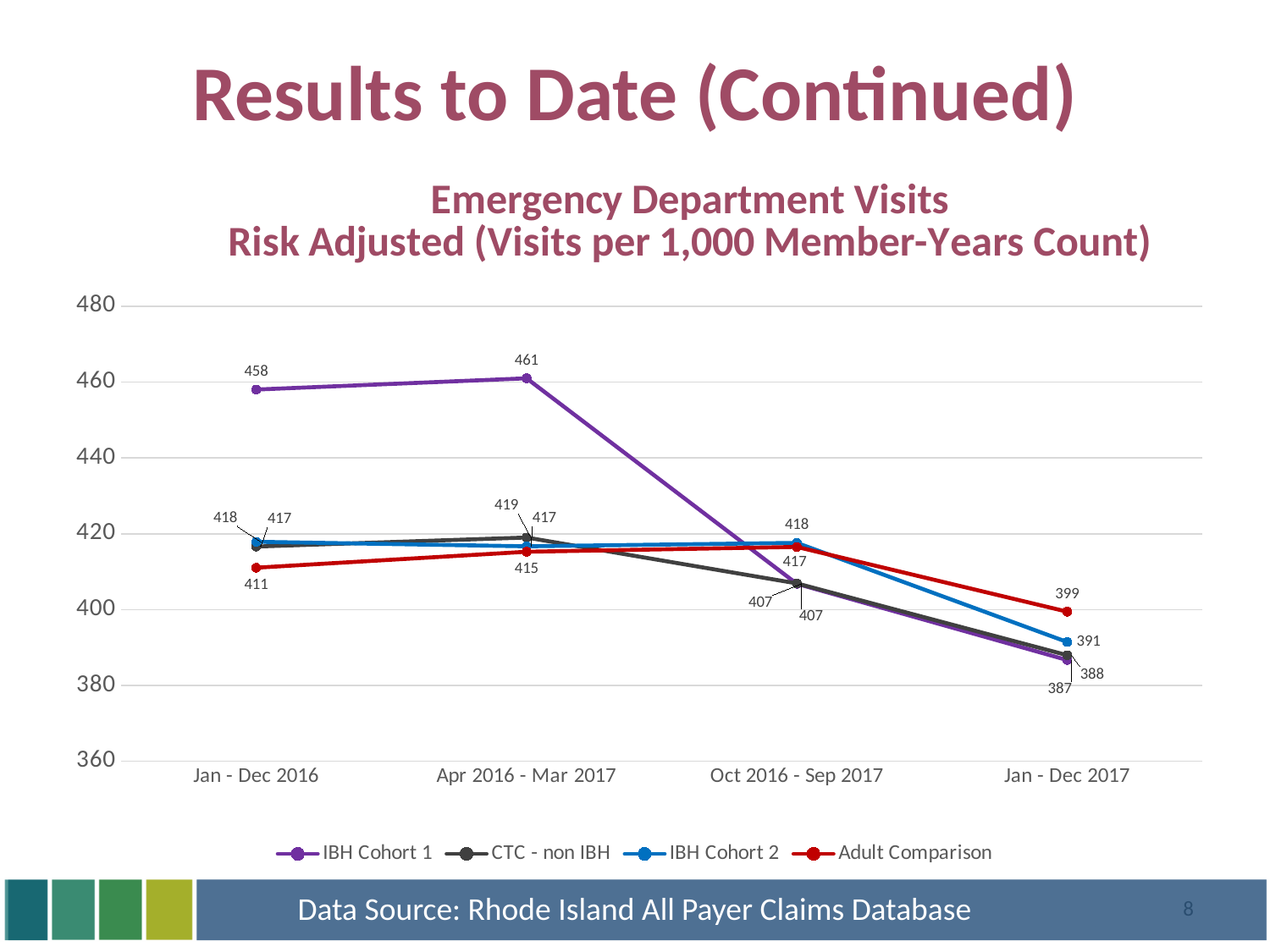
In which period is the IBH Cohort 1 value highest? Apr 2016 - Mar 2017 By how much did the IBH Cohort 1 value fall from Jan - Dec 2016 to Jan - Dec 2017? 71 In the Jan - Dec 2017 period, which is larger: Adult Comparison or IBH Cohort 2? Adult Comparison What kind of chart is shown on the slide? line chart Is the value for IBH Cohort 1 in Jan - Dec 2016 greater or less than 440? greater In which period is the Adult Comparison value lowest? Jan - Dec 2017 How many series does the legend list? 4 What is the value for Adult Comparison in the Jan - Dec 2017 period? 399 What is the value for Adult Comparison in the Jan - Dec 2016 period? 411 What is the value for IBH Cohort 1 in the Apr 2016 - Mar 2017 period? 461 How many time periods are shown on the x axis? 4 What is the value for IBH Cohort 2 in the Jan - Dec 2017 period? 391